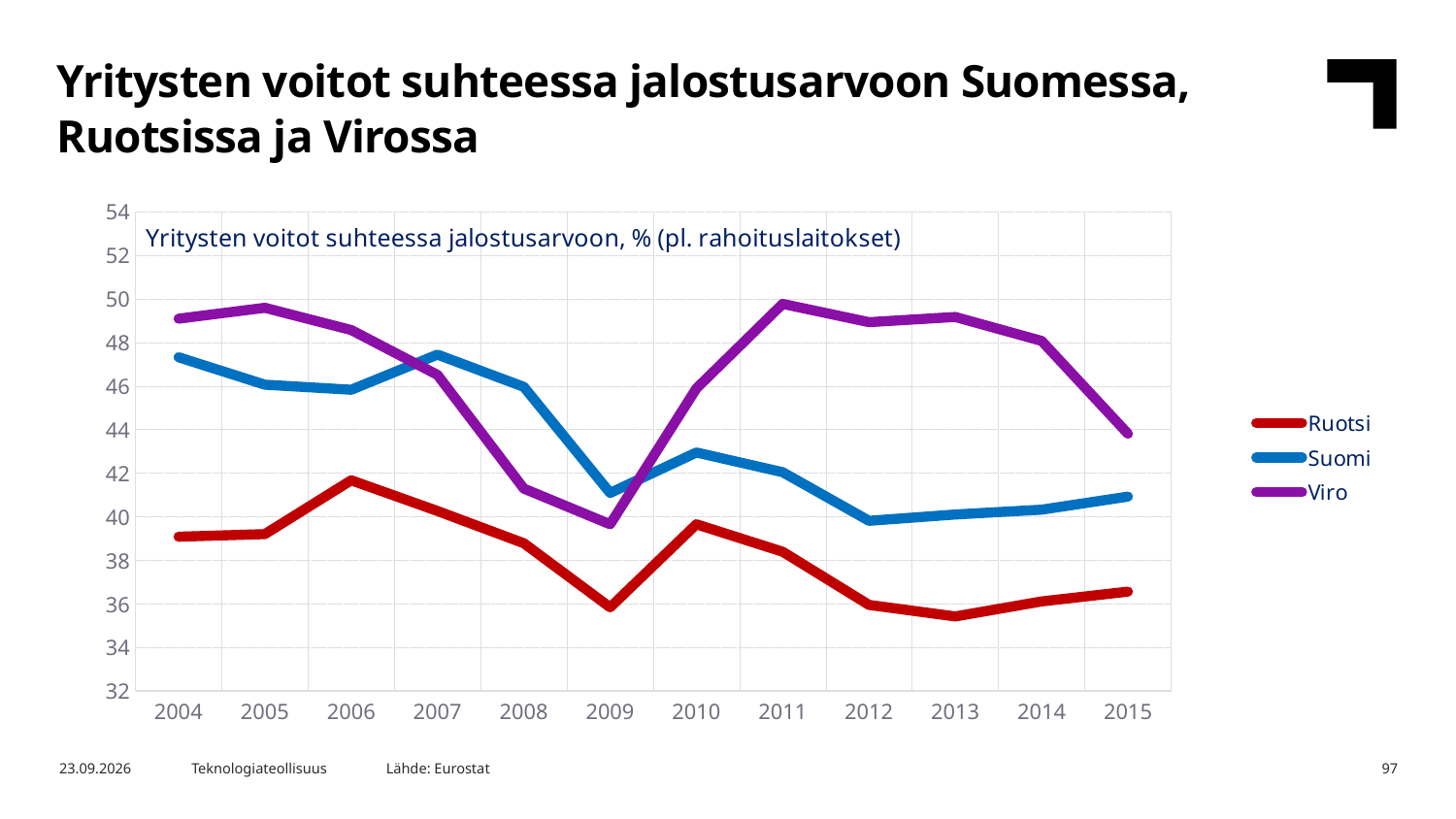
Which series has the lowest value in 2004? Ruotsi In 2009, which is larger: the value for Suomi or the value for Viro? Suomi How many series does the legend list? 3 What is the title printed inside the chart area? Yritysten voitot suhteessa jalostusarvoon, % (pl. rahoituslaitokset) Is the value for Viro in 2004 greater or less than 48? greater Is the value for Suomi in 2012 greater or less than 42? less Is the value for Ruotsi in 2009 greater or less than 38? less Does the Viro series rise or fall from 2013 to 2015? fall In which year does the Ruotsi series reach its highest value? 2006 What kind of chart is shown on the slide? line chart Which series has the highest value in 2015? Viro How many years are plotted along the x axis? 12